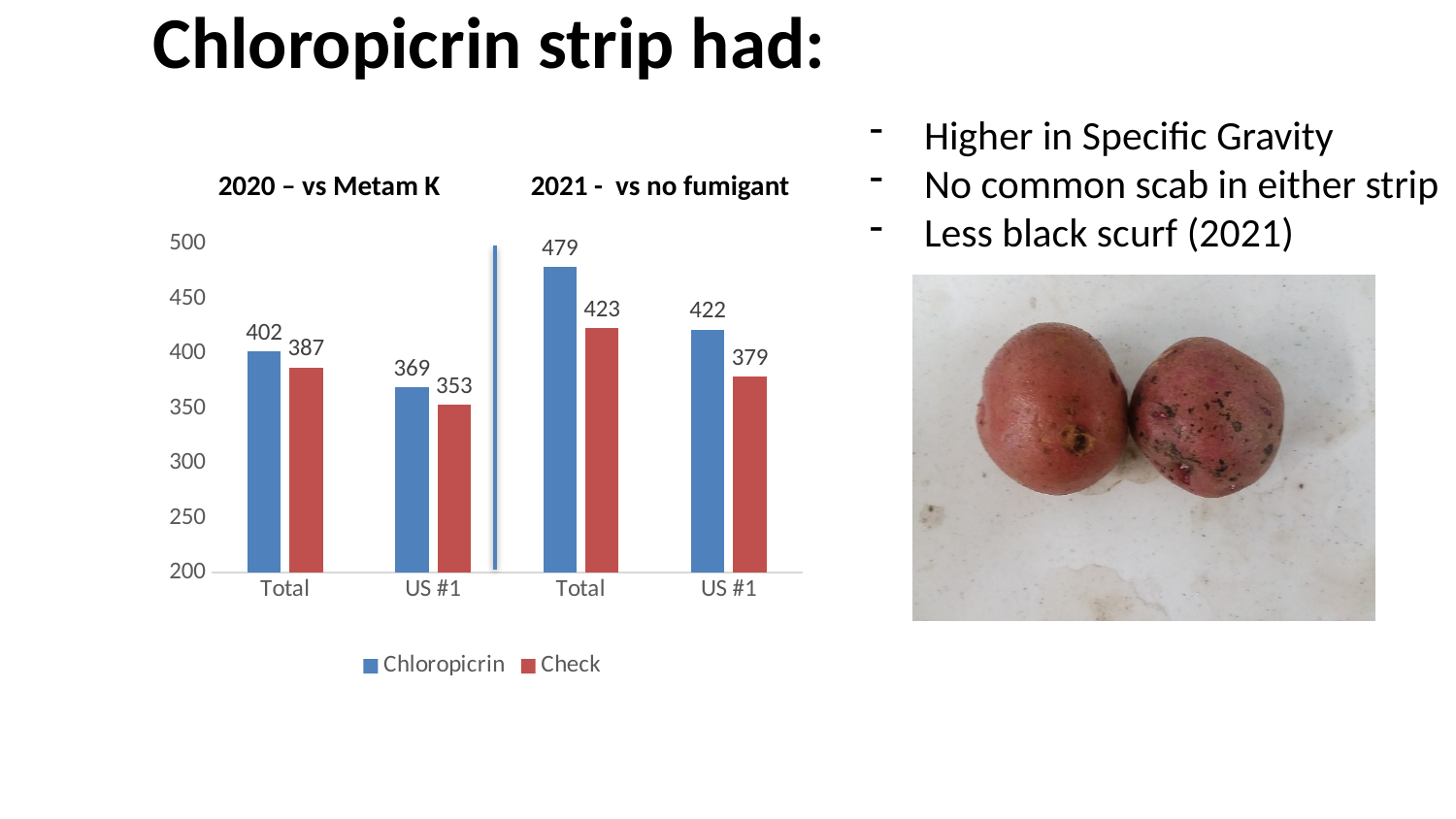
Which colour represents the Check series in the chart? Red Which bar has the highest value on the chart? Chloropicrin, Total (2021 - vs no fumigant) What is the Check value for Total in the 2020 – vs Metam K section? 387 Which is larger, the Chloropicrin value for US #1 in 2021 or the Chloropicrin value for Total in 2020? Chloropicrin US #1 in 2021 (422) What is the difference between the Chloropicrin and Check values for Total in the 2021 - vs no fumigant section? 56 What is the Chloropicrin value for Total in the 2020 – vs Metam K section? 402 Is the Check value for Total in the 2021 - vs no fumigant section greater or less than 400? greater Which bar has the lowest value on the chart? Check, US #1 (2020 – vs Metam K) What kind of chart is shown on the slide? Bar chart What is the difference between the Chloropicrin and Check values for US #1 in the 2020 – vs Metam K section? 16 How many series does the legend list? 2 What is the Check value for US #1 in the 2021 - vs no fumigant section? 379